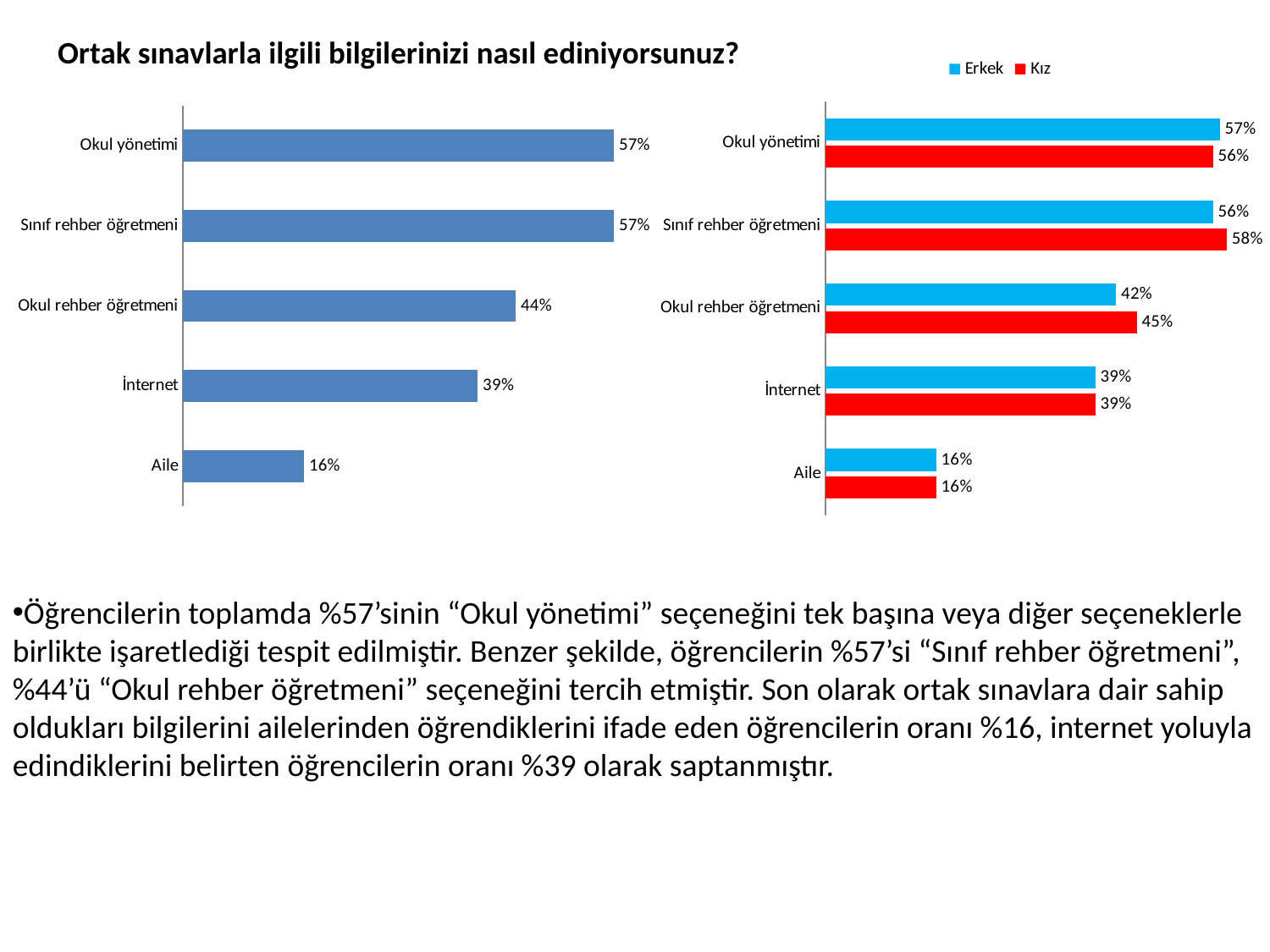
In the left chart, what is the difference between the values for Okul yönetimi and İnternet? 18% In the right chart, how many series does the legend list? 2 In the right chart, which category has the highest Kız value? Sınıf rehber öğretmeni In the right chart, what is the difference between the Kız and Erkek values for Okul rehber öğretmeni? 3% In the right chart, which is larger for Okul yönetimi, the Erkek value or the Kız value? Erkek In the right chart, what is the Erkek value for Okul rehber öğretmeni? 42% In the left chart, how many categories are shown? 5 In the left chart, what is the value for Okul rehber öğretmeni? 44% In the left chart, what is the value for Aile? 16% In the left chart, which category has the lowest value? Aile In the left chart, what kind of chart is shown? Bar chart In the right chart, what is the Kız value for Sınıf rehber öğretmeni? 58%